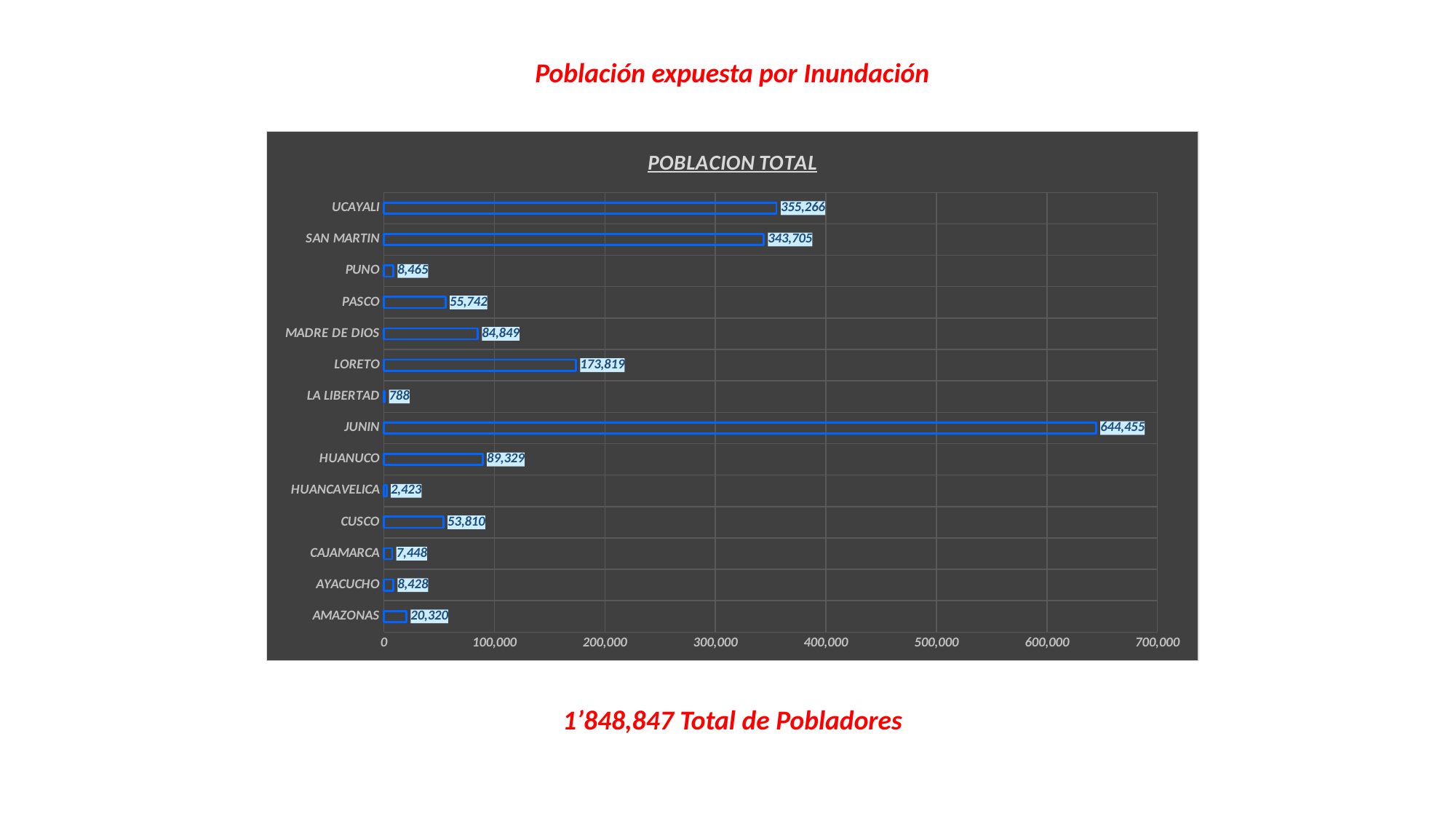
What is the difference between the values for UCAYALI and SAN MARTIN? 11,561 Which region has the highest value? JUNIN Is the value for LORETO greater or less than 100,000? greater What is the value for LA LIBERTAD? 788 How many regions (categories) are plotted in the chart? 14 What is the value for LORETO? 173,819 Which region has the lowest value? LA LIBERTAD What type of chart is shown on the slide? bar chart Which has a larger value, PASCO or CUSCO? PASCO What is the difference between the values for JUNIN and UCAYALI? 289,189 What is the title of the chart? POBLACION TOTAL What is the value for JUNIN? 644,455